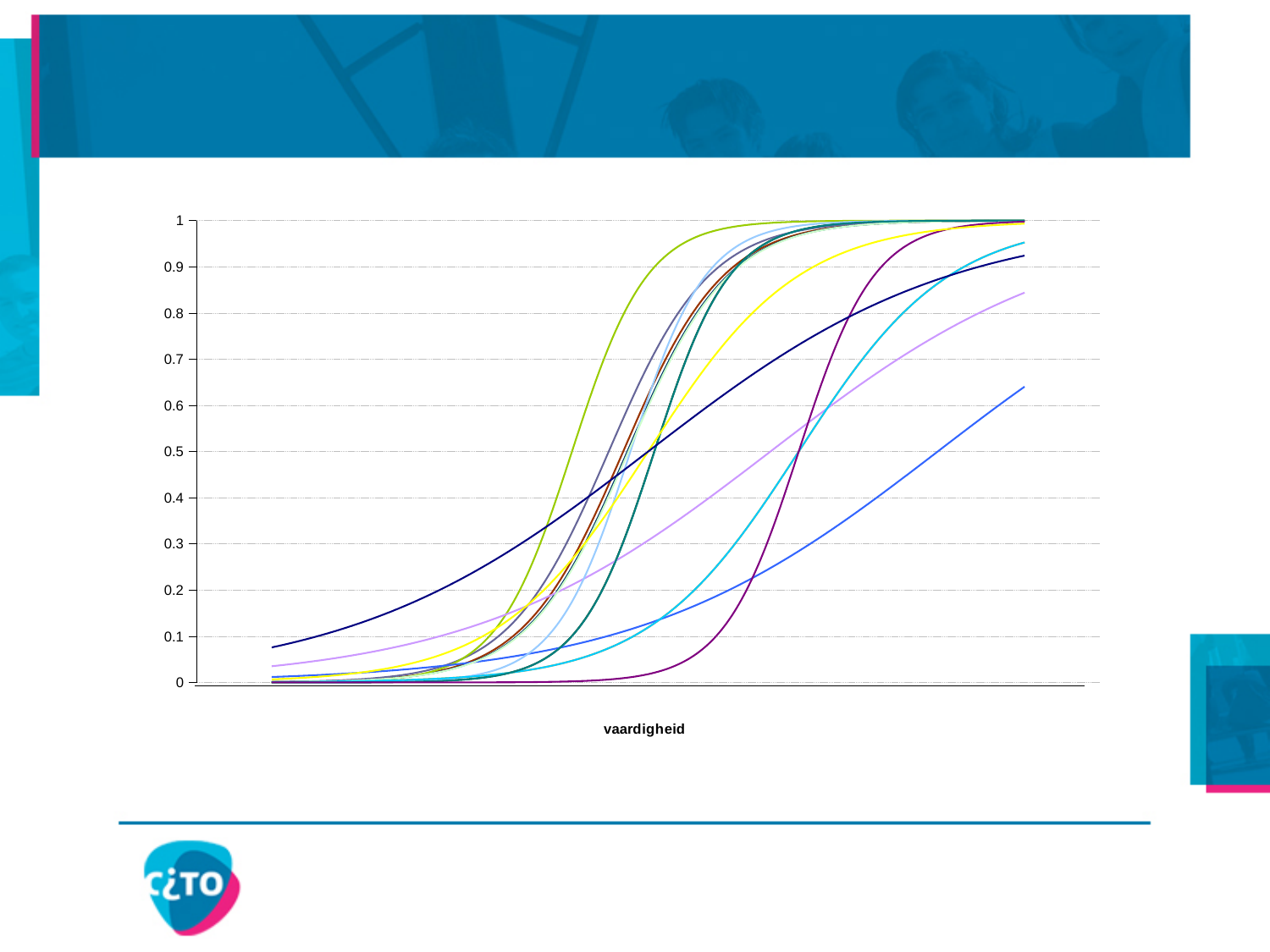
What kind of chart is shown on the slide? line chart What is the highest value shown on the y axis of the chart? 1 Do the curves in the chart rise or fall as you move from left to right along the x axis? rise What is the label on the x axis of the chart? vaardigheid